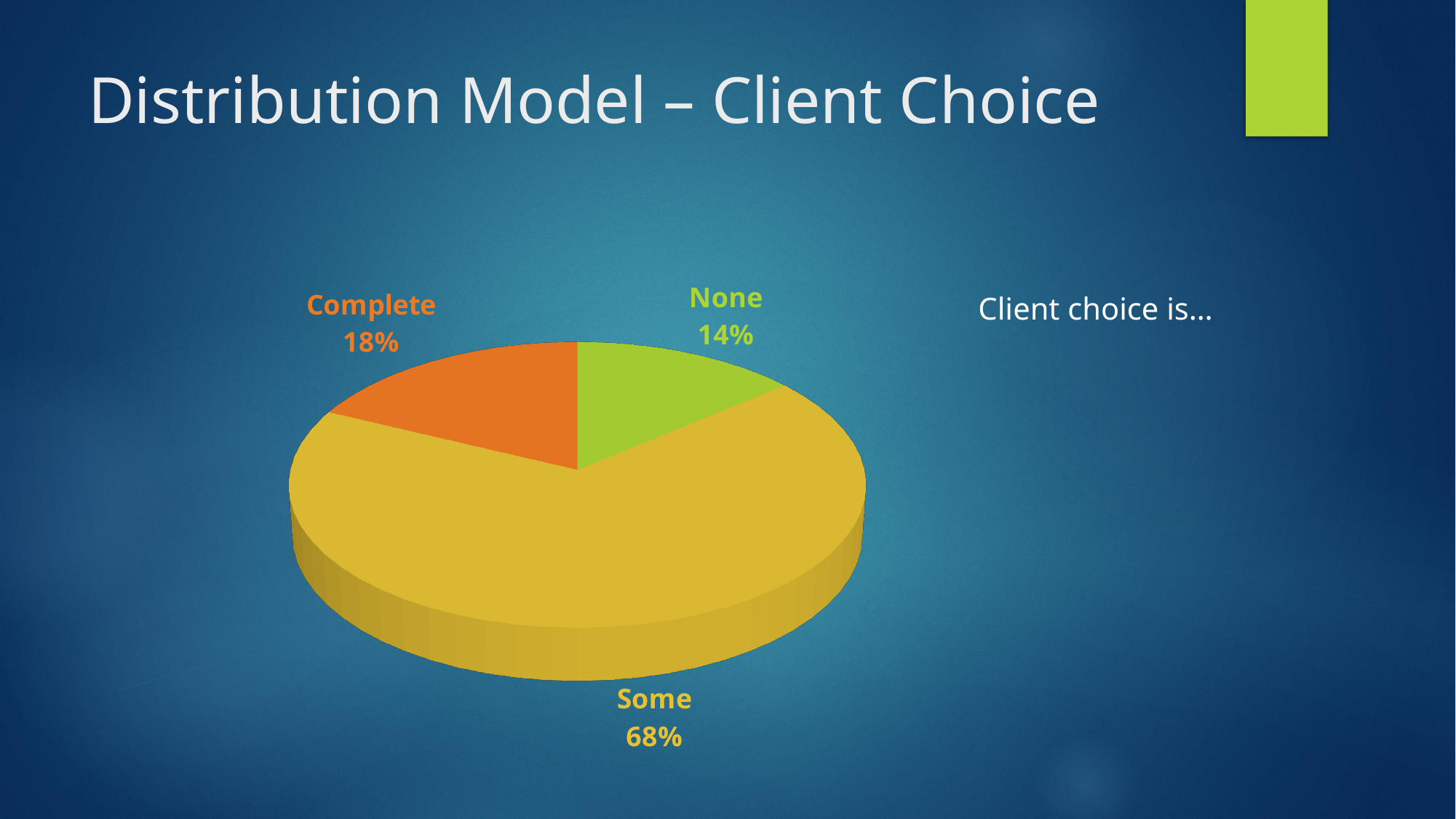
What share of the pie does the Some slice represent? 68% What kind of chart is shown on the slide? pie chart What percentage is shown for the None slice? 14% What colour is the None slice of the pie? green How many slices does the pie chart have? 3 What colour is the Some slice of the pie? yellow What is the difference in percentage points between the Some slice and the Complete slice? 50 What percentage is shown for the Complete slice? 18% Which is larger, the Complete slice or the None slice? Complete Which slice of the pie is the smallest? None Which slice of the pie is the largest? Some What is the difference in percentage points between the Complete slice and the None slice? 4